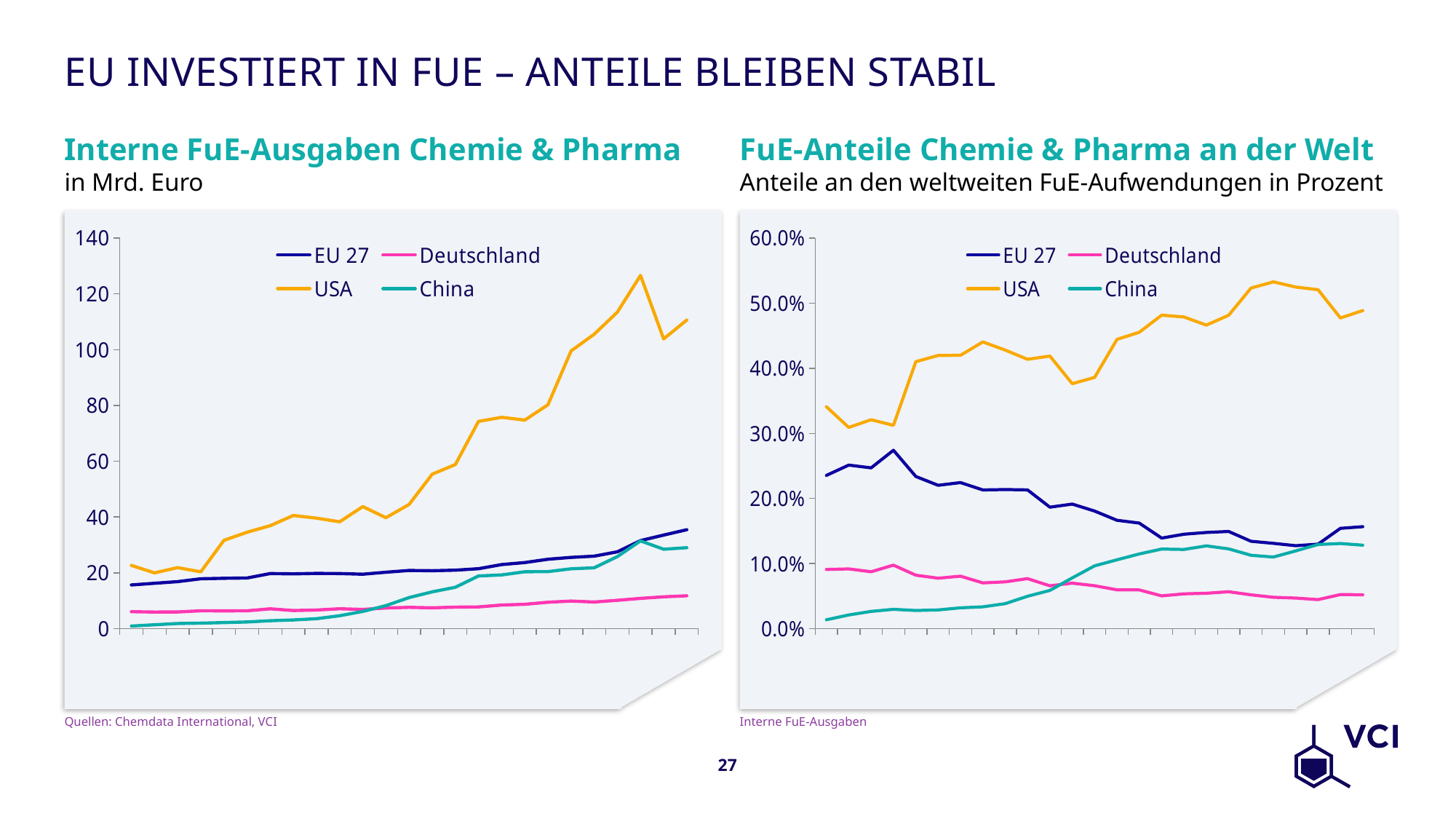
What kind of chart is the left chart, "Interne FuE-Ausgaben Chemie & Pharma"? Line chart How many series does the legend of the left chart, "Interne FuE-Ausgaben Chemie & Pharma", list? 4 In the left chart, "Interne FuE-Ausgaben Chemie & Pharma", is the peak value for USA greater or less than 100? greater In the right chart, "FuE-Anteile Chemie & Pharma an der Welt", do the values for EU 27 rise or fall overall along the x axis? Fall In the right chart, "FuE-Anteile Chemie & Pharma an der Welt", which series is higher at the right end of the x axis, USA or EU 27? USA In the left chart, "Interne FuE-Ausgaben Chemie & Pharma", which series has the highest values at the right end of the x axis? USA In the right chart, "FuE-Anteile Chemie & Pharma an der Welt", do the values for China rise or fall overall along the x axis? Rise In the right chart, "FuE-Anteile Chemie & Pharma an der Welt", is the final value for USA greater or less than 40.0%? greater Which series are listed in the legend of the right chart, "FuE-Anteile Chemie & Pharma an der Welt"? EU 27, Deutschland, USA, China In the left chart, "Interne FuE-Ausgaben Chemie & Pharma", which series has the lowest value at the right end of the x axis? Deutschland In the left chart, "Interne FuE-Ausgaben Chemie & Pharma", is the final value for China greater or less than 20? greater In the left chart, "Interne FuE-Ausgaben Chemie & Pharma", do the values for USA rise or fall overall along the x axis? Rise